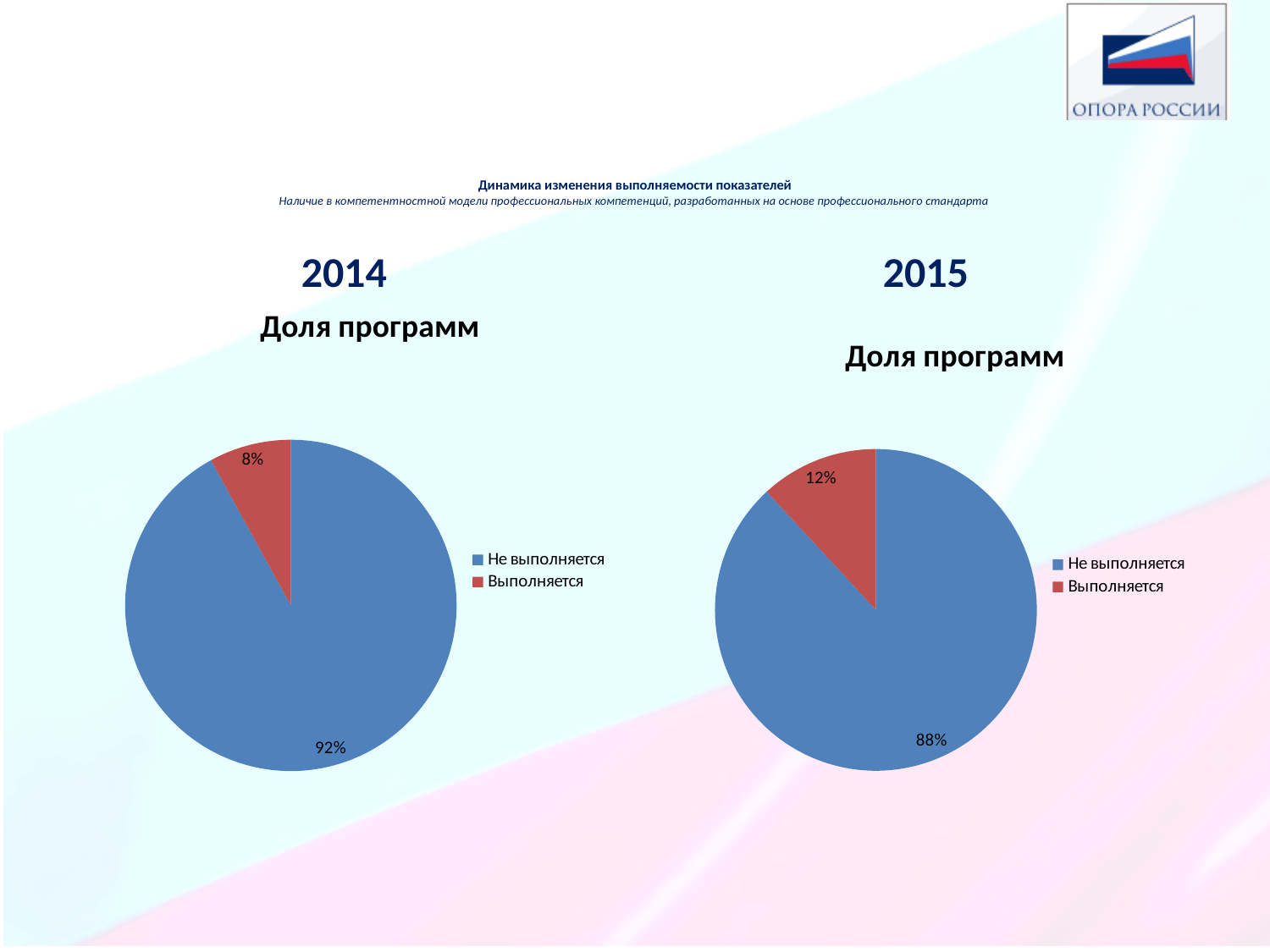
What is the difference between the "Выполняется" share in 2015 and in 2014? 4% What is the title shown above the 2015 pie chart? Доля программ In the 2015 pie chart, what share is labelled for "Выполняется"? 12% How many entries does the legend of the 2014 pie chart list? 2 In the 2015 pie chart, which category has the smallest slice? Выполняется In the 2014 pie chart, which category has the largest slice? Не выполняется In the 2014 pie chart, what share is labelled for "Выполняется"? 8% Which is larger: the "Не выполняется" share in 2014 or in 2015? 2014 In the 2015 pie chart, what share is labelled for "Не выполняется"? 88% What type of chart is used for the 2014 data? Pie chart In the 2014 pie chart, what share is labelled for "Не выполняется"? 92% How many slices does the 2015 pie chart have? 2